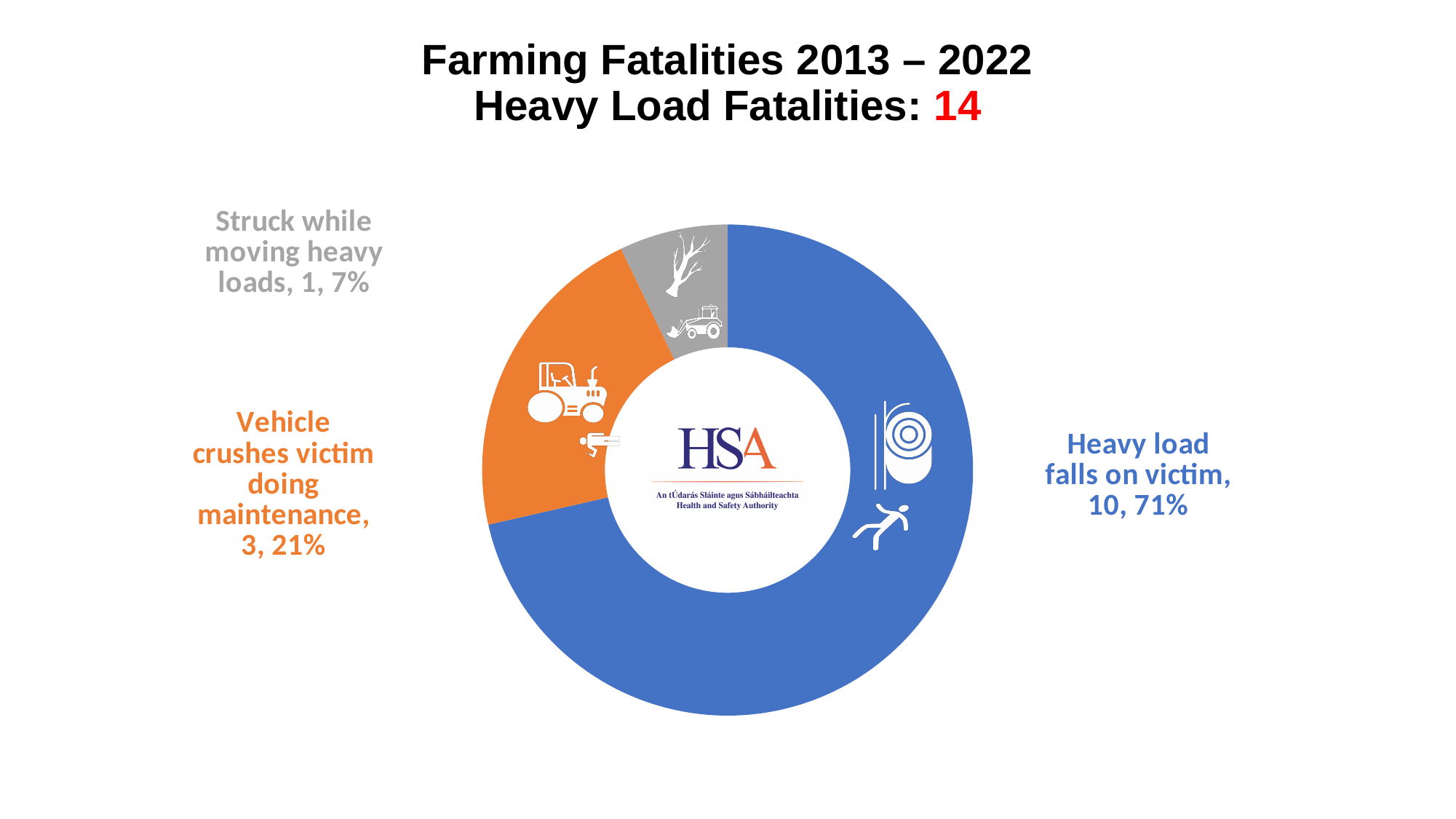
How many fatalities are attributed to 'Struck while moving heavy loads'? 1 How many fatalities are attributed to 'Heavy load falls on victim'? 10 What is the difference in fatalities between 'Heavy load falls on victim' and 'Vehicle crushes victim doing maintenance'? 7 What percentage share does 'Vehicle crushes victim doing maintenance' have? 21% What percentage share does 'Heavy load falls on victim' have? 71% Which category has the highest number of fatalities? Heavy load falls on victim What kind of chart is shown on the slide? Doughnut (pie) chart What is the total number of heavy load fatalities stated in the title? 14 Which category has the lowest number of fatalities? Struck while moving heavy loads How many categories does the chart show? 3 How many fatalities are attributed to 'Vehicle crushes victim doing maintenance'? 3 What percentage share does 'Struck while moving heavy loads' have? 7%